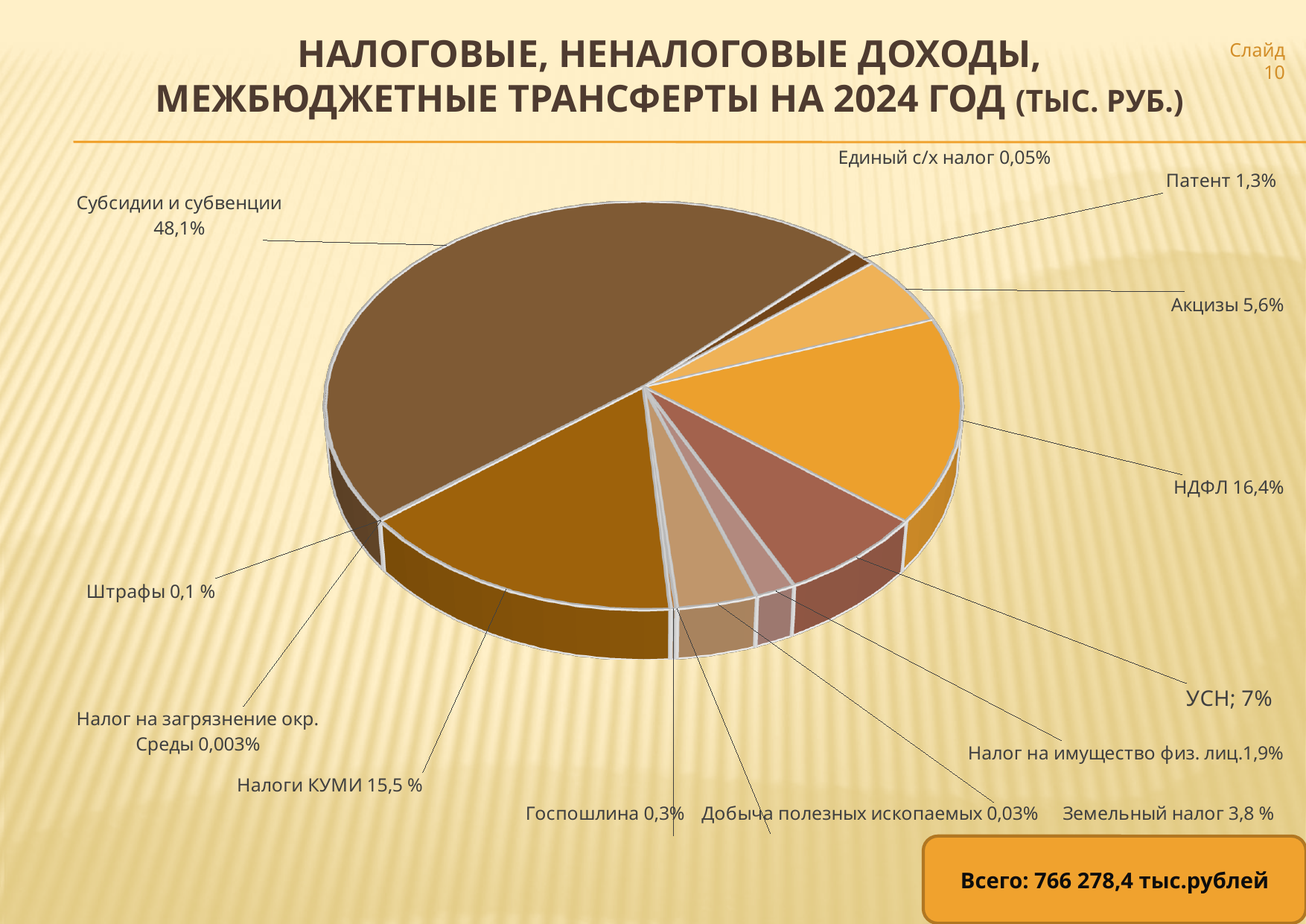
Which category has the largest share of the pie? Субсидии и субвенции Which has a larger share, УСН or Акцизы? УСН What type of chart is shown on the slide? Pie chart How many categories are labelled on the pie chart? 13 What is the difference in percentage points between НДФЛ and Налоги КУМИ? 0,9 What share is shown for Земельный налог? 3,8 % What share is shown for НДФЛ? 16,4% What share is shown for Акцизы? 5,6% What share of the pie is labelled for Субсидии и субвенции? 48,1% Which category has the smallest share of the pie? Налог на загрязнение окр. Среды What total amount is shown in the box at the bottom right of the slide? 766 278,4 тыс.рублей What share is shown for Налоги КУМИ? 15,5 %